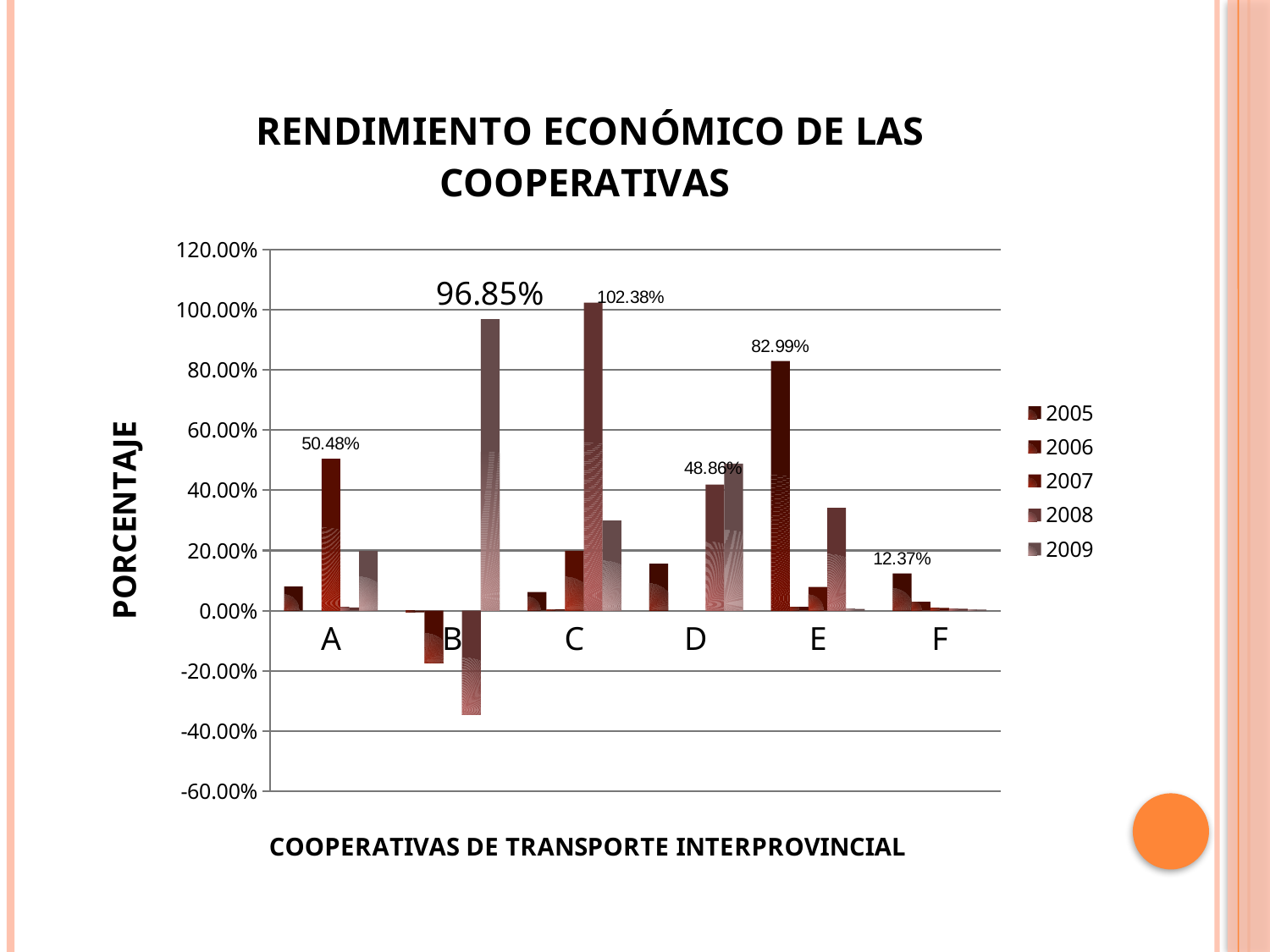
Is the 2008 value for cooperative B greater or less than -20.00%? less What is the difference between the 2008 value for C (102.38%) and the 2009 value for B (96.85%)? 5.53% Which cooperative has the tallest bar in the chart? C What is the 2005 value for cooperative E? 82.99% What kind of chart is shown on the slide? bar chart How many cooperatives (categories) are shown on the x axis? 6 What is the 2005 value for cooperative F? 12.37% What is the 2006 value for cooperative A? 0.00% How many series does the legend list? 5 What is the 2009 value for cooperative B? 96.85% What is the 2008 value for cooperative C? 102.38% What is the title of the y axis? PORCENTAJE